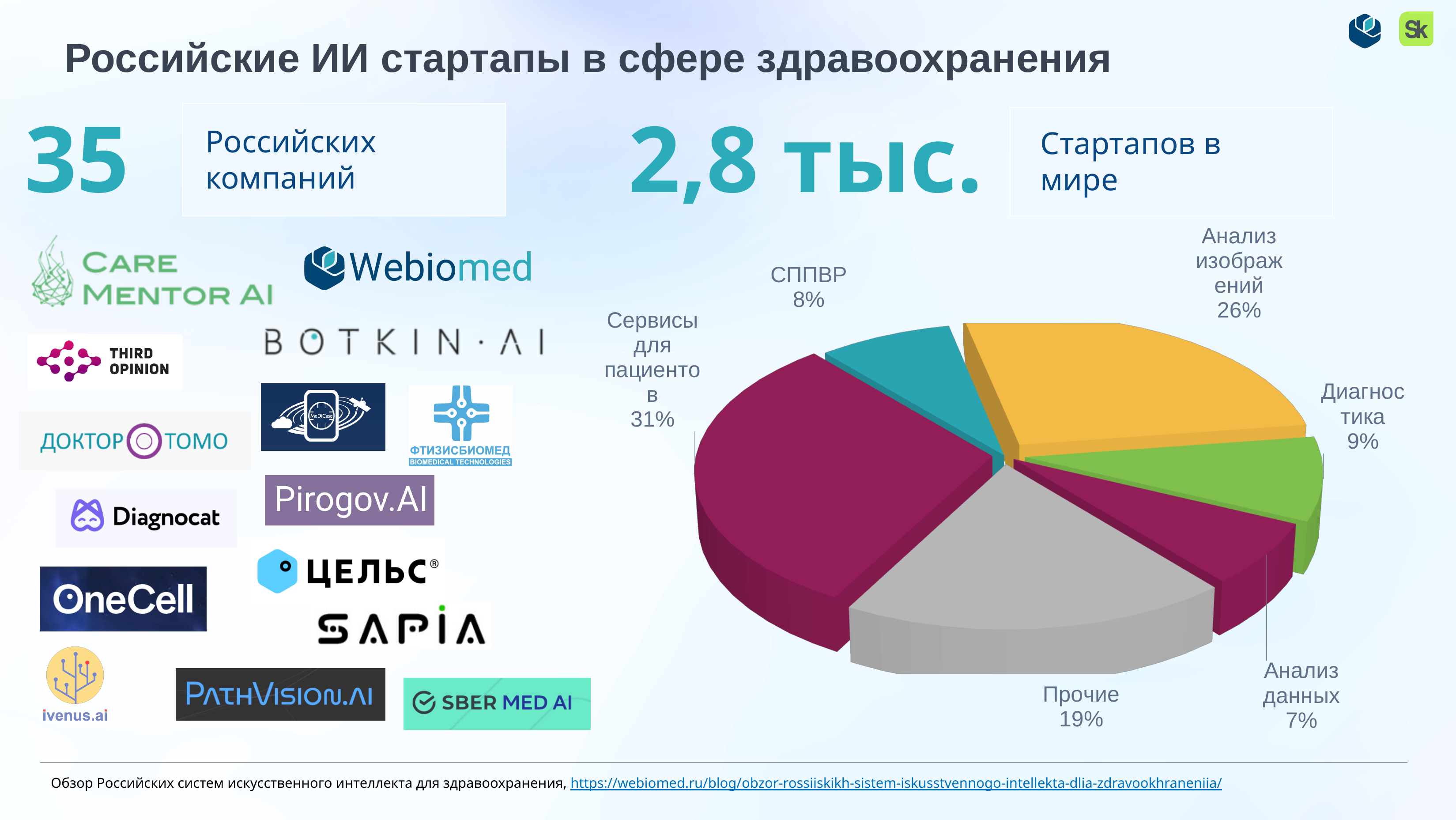
What is the value shown for "СППВР" in the pie chart? 8% What share of the pie chart is labelled "Сервисы для пациентов"? 31% What percentage does the "Анализ изображений" slice show? 26% What percentage is shown for "Прочие"? 19% How many slices does the pie chart have? 6 Which category has the largest share in the pie chart? Сервисы для пациентов Which category has the smallest share in the pie chart? Анализ данных What type of chart is shown on the slide? Pie chart What is the difference in percentage points between "Сервисы для пациентов" and "Анализ изображений"? 5 What is the combined share of "Диагностика" and "Анализ данных"? 16% Which is larger: the share for "Диагностика" or the share for "СППВР"? Диагностика What colour is the "Прочие" slice in the pie chart? Grey